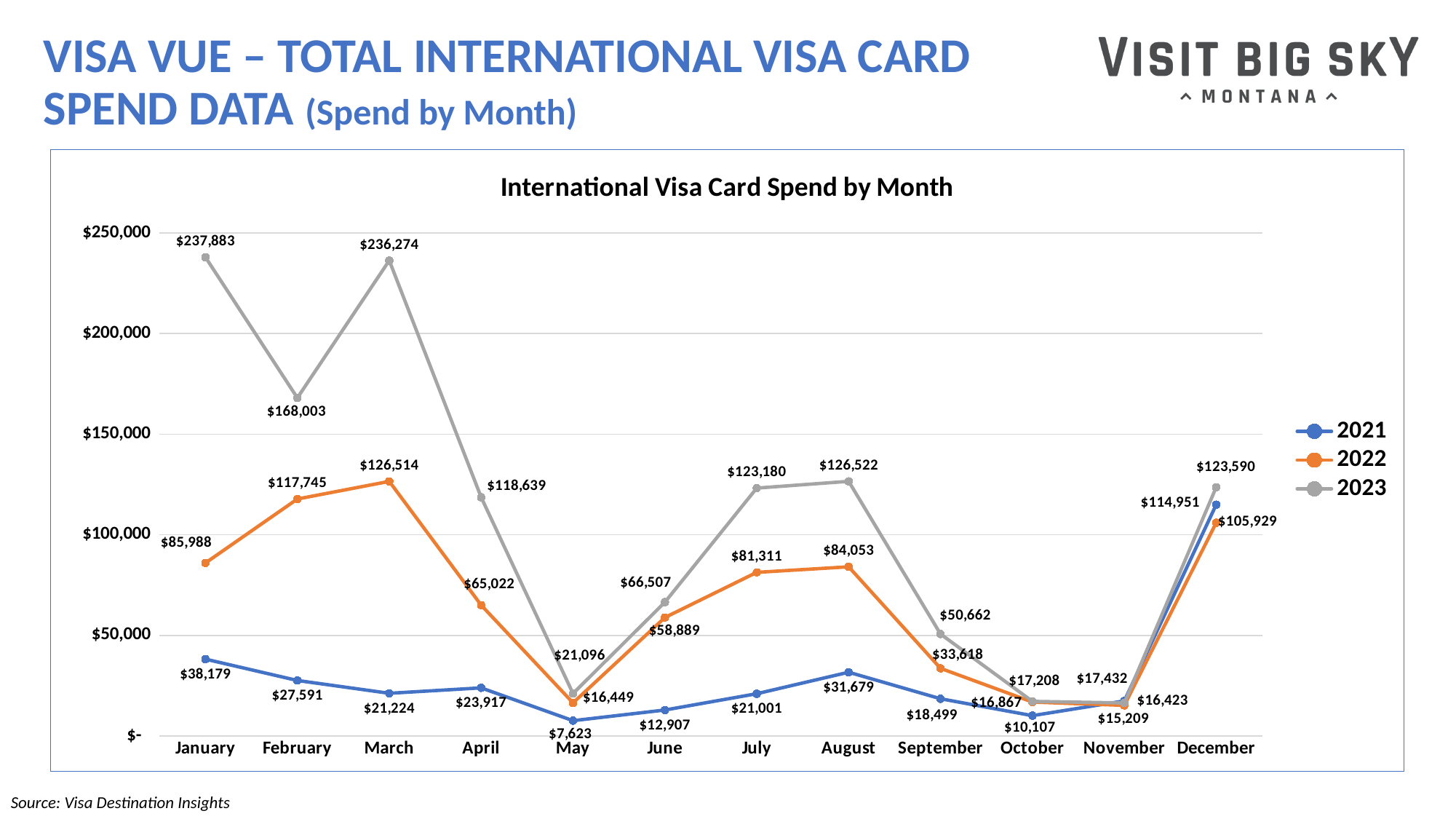
What is the difference between the 2022 and 2021 spend in March? $105,290 How many series does the legend list? 3 How many months are shown on the x axis? 12 Is the 2023 spend in April greater or less than $100,000? greater What was the 2021 spend in December? $114,951 What kind of chart is shown on the slide? Line chart How much higher was the 2023 spend in January than in February? $69,880 What was the 2023 international Visa card spend in January? $237,883 In which month was the 2021 spend lowest? May In which month was the 2022 spend highest? March What was the 2022 spend in August? $84,053 Which year had the higher spend in December, 2021 or 2022? 2021